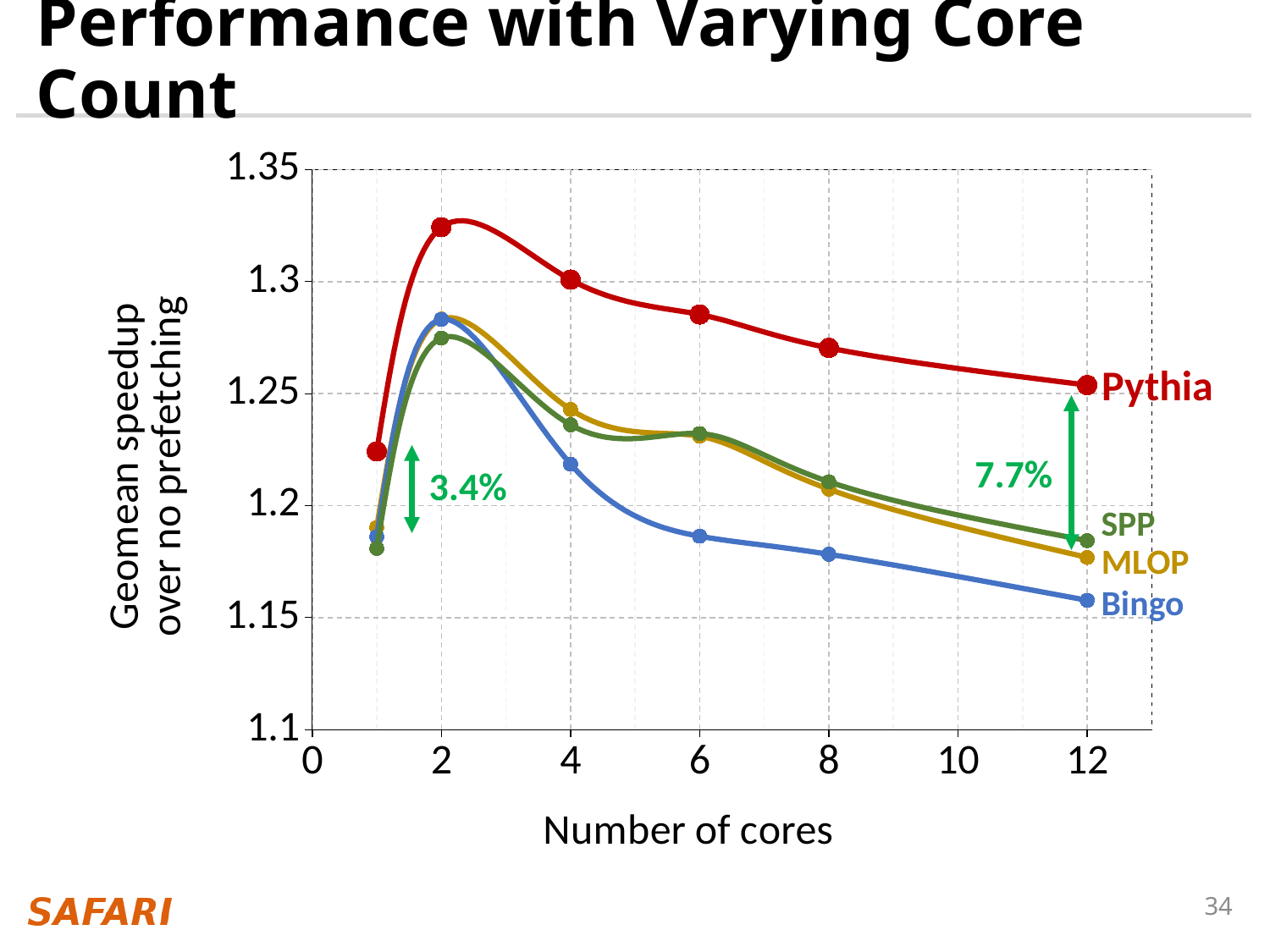
What is the label of the x axis? Number of cores Is the geomean speedup of Pythia at 2 cores greater or less than 1.3? greater Which series has the highest geomean speedup at 2 cores? Pythia Is the geomean speedup of Bingo at 12 cores greater or less than 1.2? less Which is larger at 8 cores: the geomean speedup of Pythia or of Bingo? Pythia Which series has the highest geomean speedup at 12 cores? Pythia What kind of chart is shown on the slide? line chart How many series (prefetchers) are plotted in the chart? 4 How does the geomean speedup of Pythia change as the number of cores increases from 2 to 12? It falls What percentage improvement is annotated between Pythia and the next-best prefetcher at 12 cores? 7.7% Which series has the lowest geomean speedup at 12 cores? Bingo